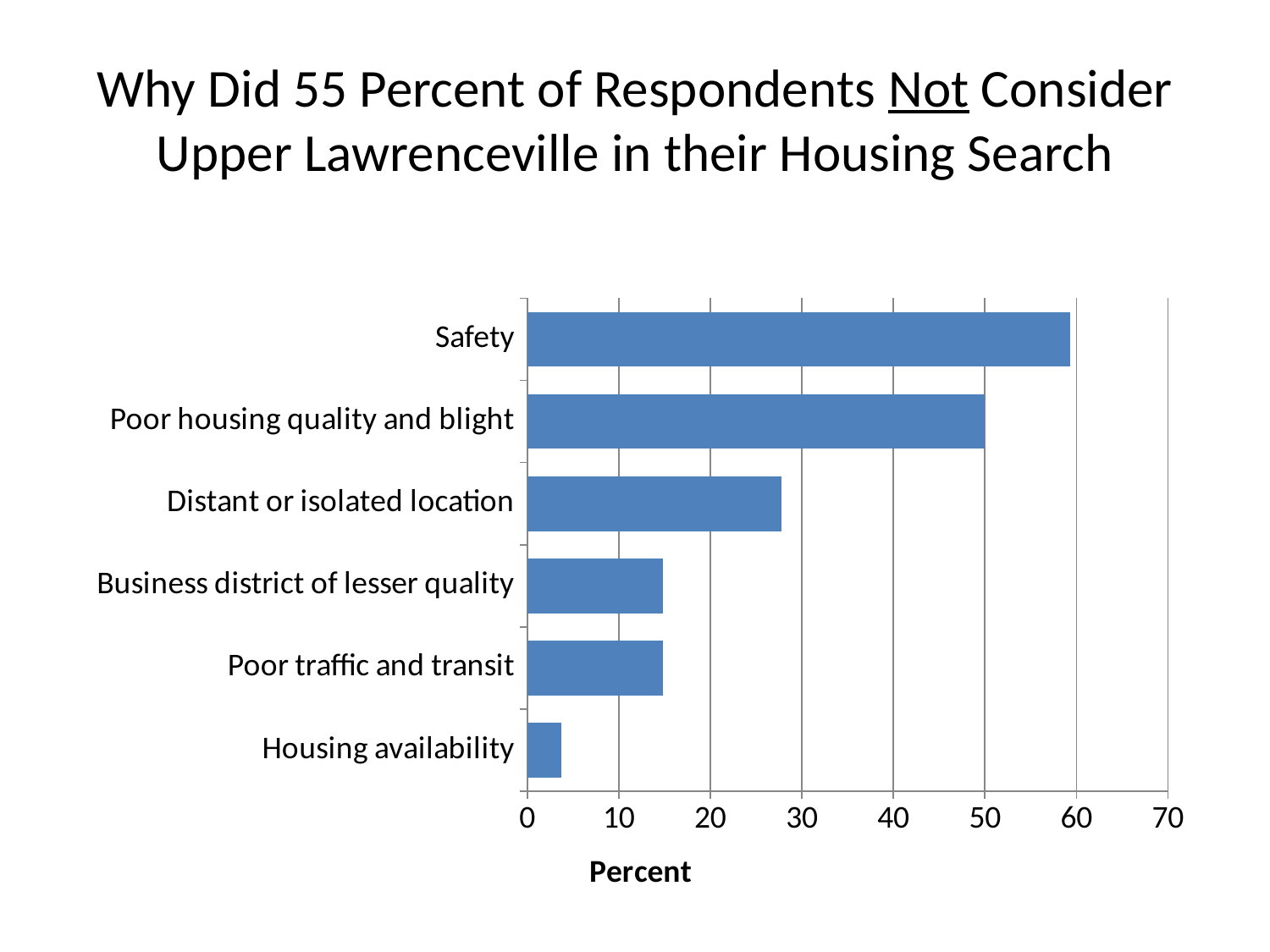
What kind of chart is shown on the slide? bar chart How many categories (reasons) are plotted in the chart? 6 What is the label on the horizontal axis of the chart? Percent Is the value for Distant or isolated location greater or less than 30? less Which is larger: the value for Safety or the value for Distant or isolated location? Safety Is the value for Safety greater or less than 50? greater Is the value for Poor housing quality and blight greater or less than 40? greater Which is larger: the value for Poor traffic and transit or the value for Housing availability? Poor traffic and transit Which reason has the lowest value in the chart? Housing availability Which reason has the highest value in the chart? Safety